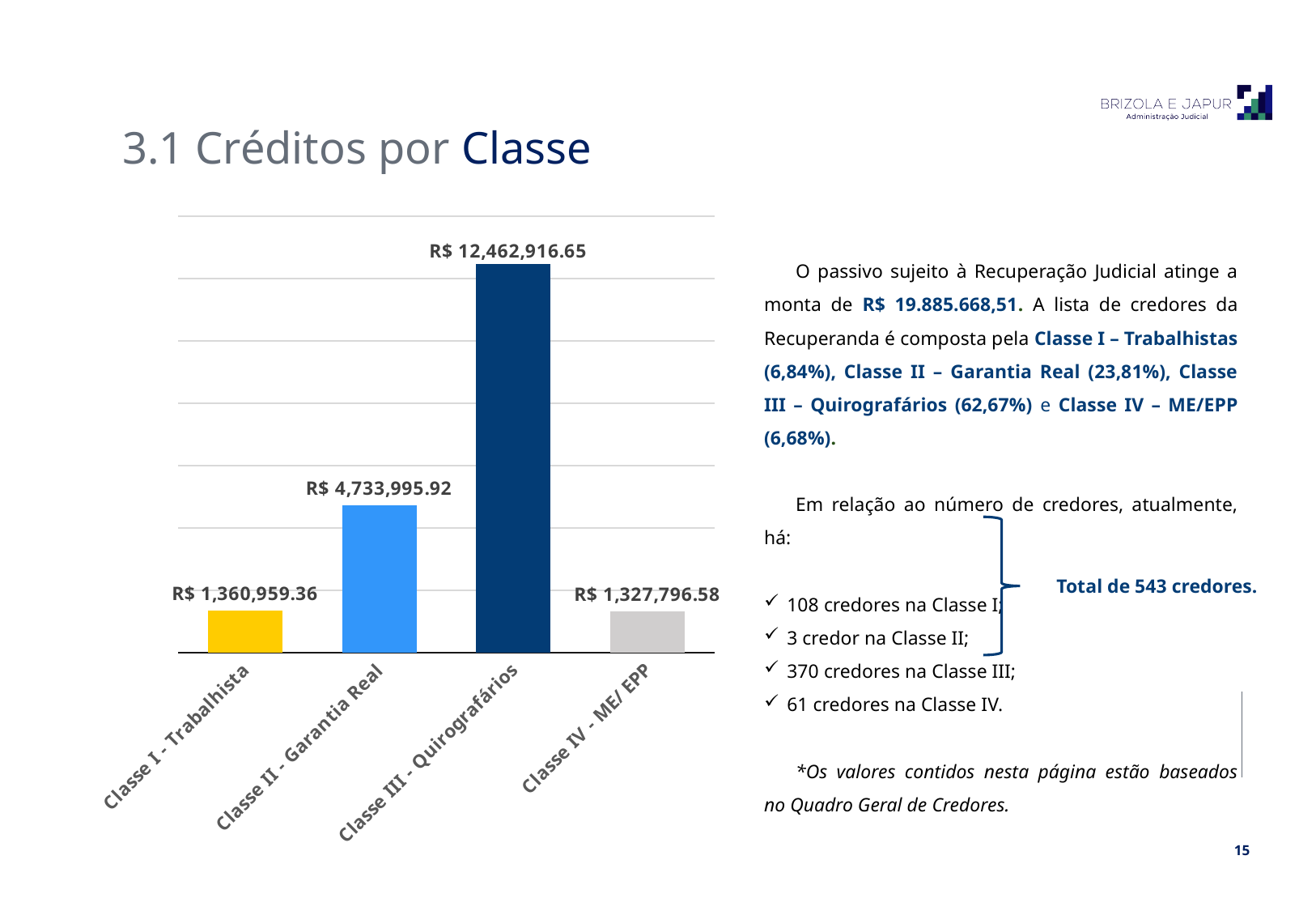
What is the value for Classe IV - ME/ EPP? R$ 1,327,796.58 What is the value for Classe II - Garantia Real? R$ 4,733,995.92 What is the value for Classe III - Quirografários? R$ 12,462,916.65 What is the difference between Classe II - Garantia Real and Classe I - Trabalhista? R$ 3,373,036.56 How many classes are shown in the chart? 4 What is the difference between Classe III - Quirografários and Classe II - Garantia Real? R$ 7,728,920.73 Which class has the lowest value? Classe IV - ME/ EPP What is the value for Classe I - Trabalhista? R$ 1,360,959.36 What kind of chart is shown on the slide? Bar chart Which is larger, Classe I - Trabalhista or Classe IV - ME/ EPP? Classe I - Trabalhista Which class has the highest value? Classe III - Quirografários What colour is the bar for Classe I - Trabalhista? Yellow